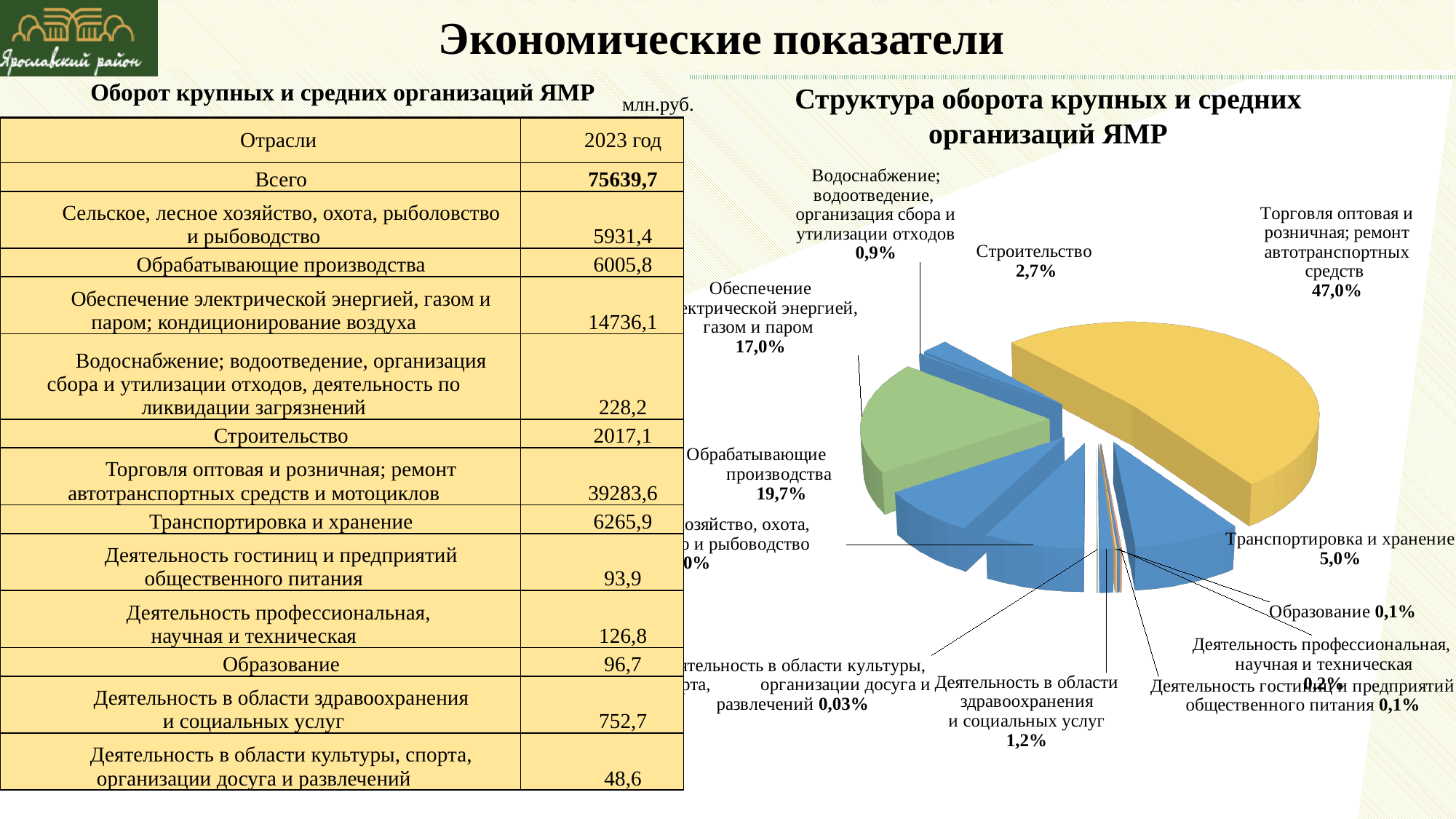
In the pie chart, what share does «Строительство» have? 2,7% In the pie chart, what share does «Деятельность в области здравоохранения и социальных услуг» have? 1,2% What type of chart is shown on the right side of the slide? Pie chart In the pie chart, what share does «Торговля оптовая и розничная; ремонт автотранспортных средств» have? 47,0% What is the title of the chart on the slide? Структура оборота крупных и средних организаций ЯМР In the pie chart, by how many percentage points does the share of «Торговля оптовая и розничная; ремонт автотранспортных средств» exceed that of «Обрабатывающие производства»? 27,3 percentage points In the pie chart, which category has the largest share? Торговля оптовая и розничная; ремонт автотранспортных средств In the pie chart, what share does «Транспортировка и хранение» have? 5,0% In the pie chart, what share does «Обрабатывающие производства» have? 19,7% In the pie chart, what share does «Обеспечение электрической энергией, газом и паром» have? 17,0% In the pie chart, which has the larger share: «Строительство» or «Транспортировка и хранение»? Транспортировка и хранение In the pie chart, which category has the smallest share? Деятельность в области культуры, спорта, организации досуга и развлечений